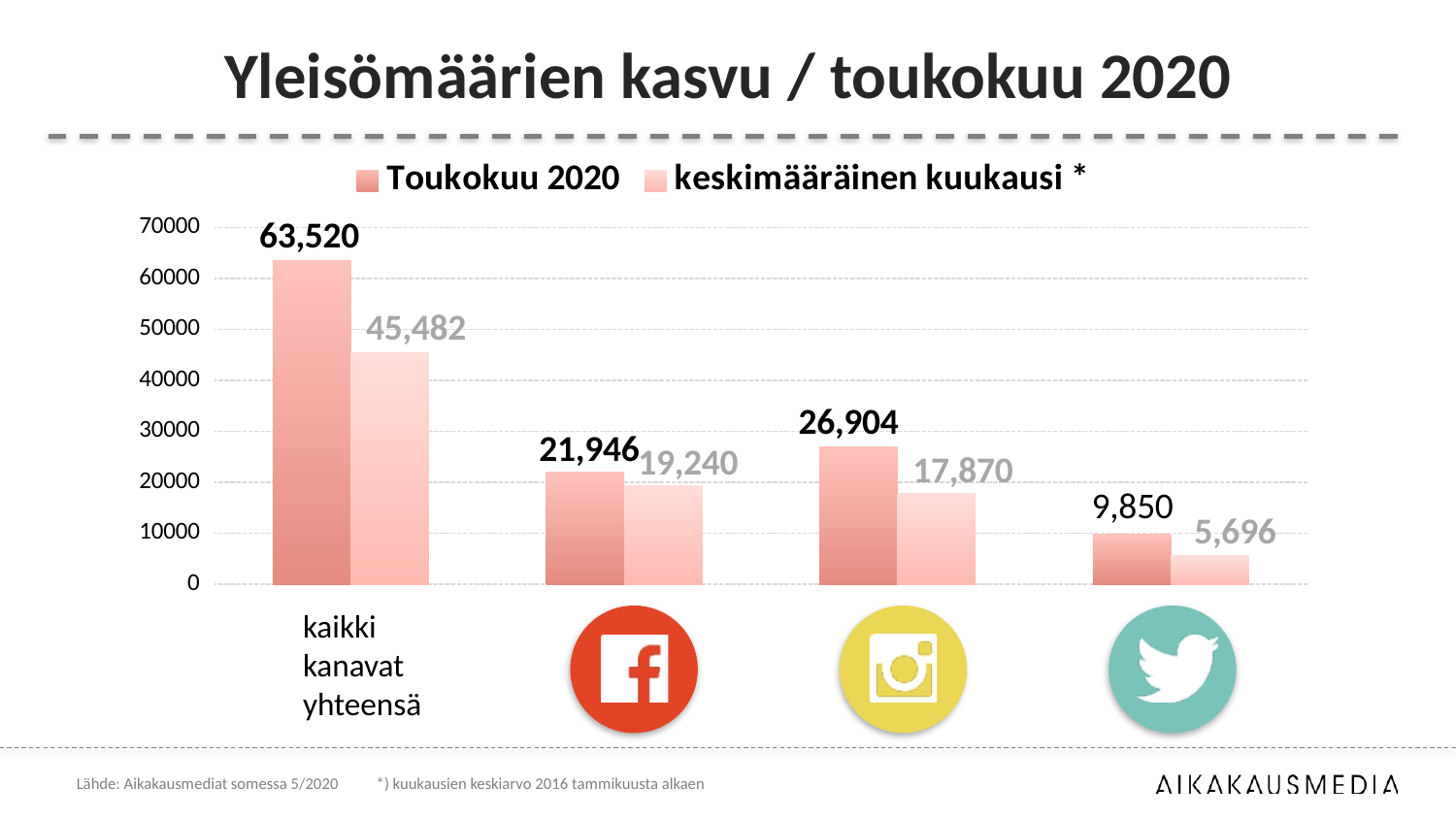
What is the Toukokuu 2020 value for "kaikki kanavat yhteensä"? 63,520 What is the difference between the Toukokuu 2020 and keskimääräinen kuukausi values for the Instagram category? 9,034 How many categories are shown on the x axis? 4 What is the title of the slide? Yleisömäärien kasvu / toukokuu 2020 What kind of chart is shown on the slide? bar chart Which is larger for the Facebook category: the Toukokuu 2020 value or the keskimääräinen kuukausi value? Toukokuu 2020 What is the keskimääräinen kuukausi value for "kaikki kanavat yhteensä"? 45,482 How many series does the legend list? 2 What is the keskimääräinen kuukausi value for the Twitter category? 5,696 Which category has the highest keskimääräinen kuukausi value? kaikki kanavat yhteensä What is the Toukokuu 2020 value for the Instagram category? 26,904 Which category has the lowest Toukokuu 2020 value? Twitter